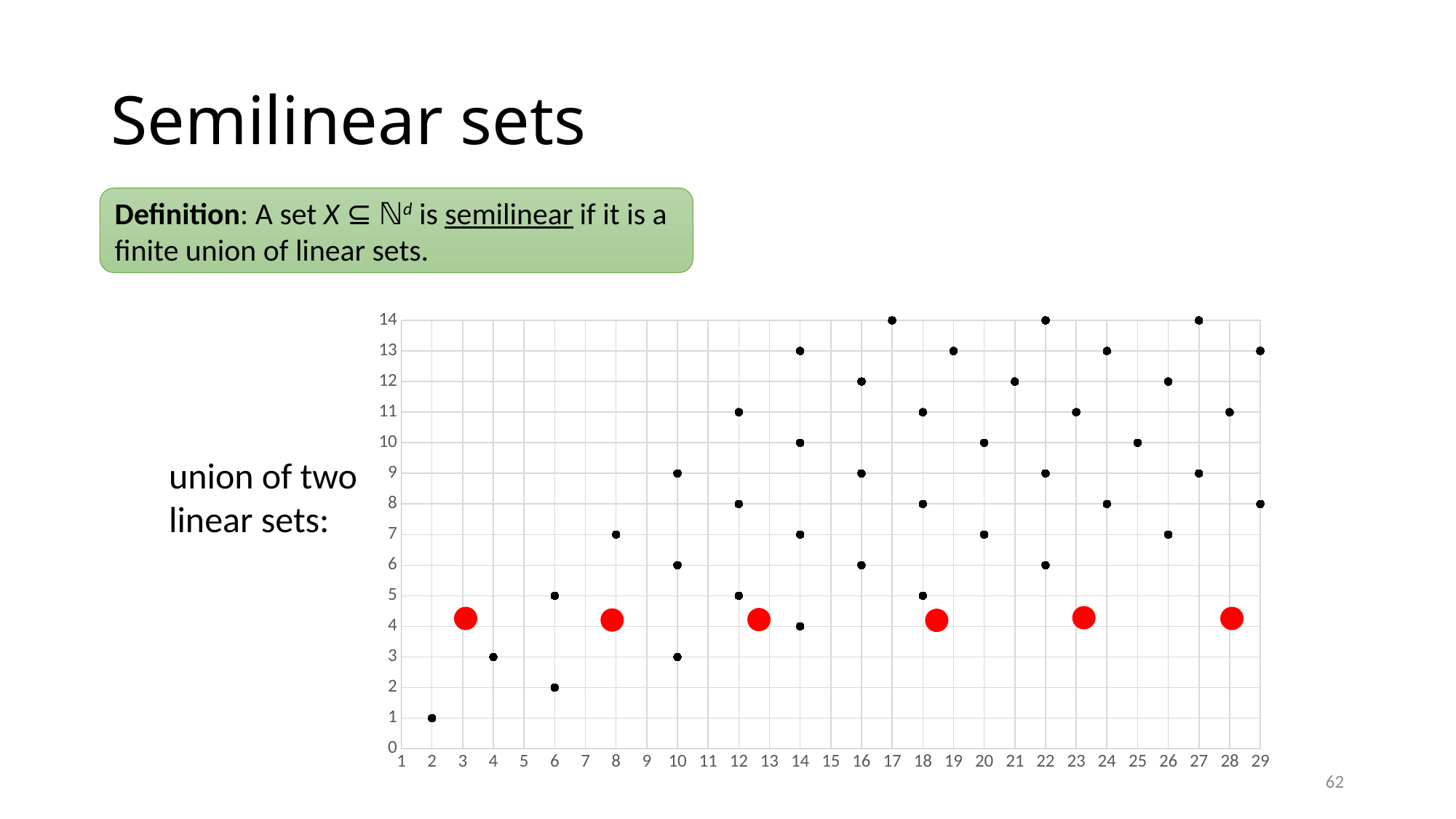
What is the x value of the last (rightmost) large red point? 28 What is the y value of the black point at x = 8? 7 What is the highest tick label shown on the y axis? 14 What is the horizontal spacing (difference in x) between consecutive large red points? 5 How many large red points are plotted on the chart? 6 At what y value do all the large red points lie? 4 What is the x value of the first (leftmost) large red point? 3 What kind of chart is shown on the slide? scatter chart What is the highest tick label shown on the x axis? 29 What is the y value of the black point at x = 17? 14 What is the y value of the black point at x = 2? 1 Is the y value of the large red points greater or less than 5? less